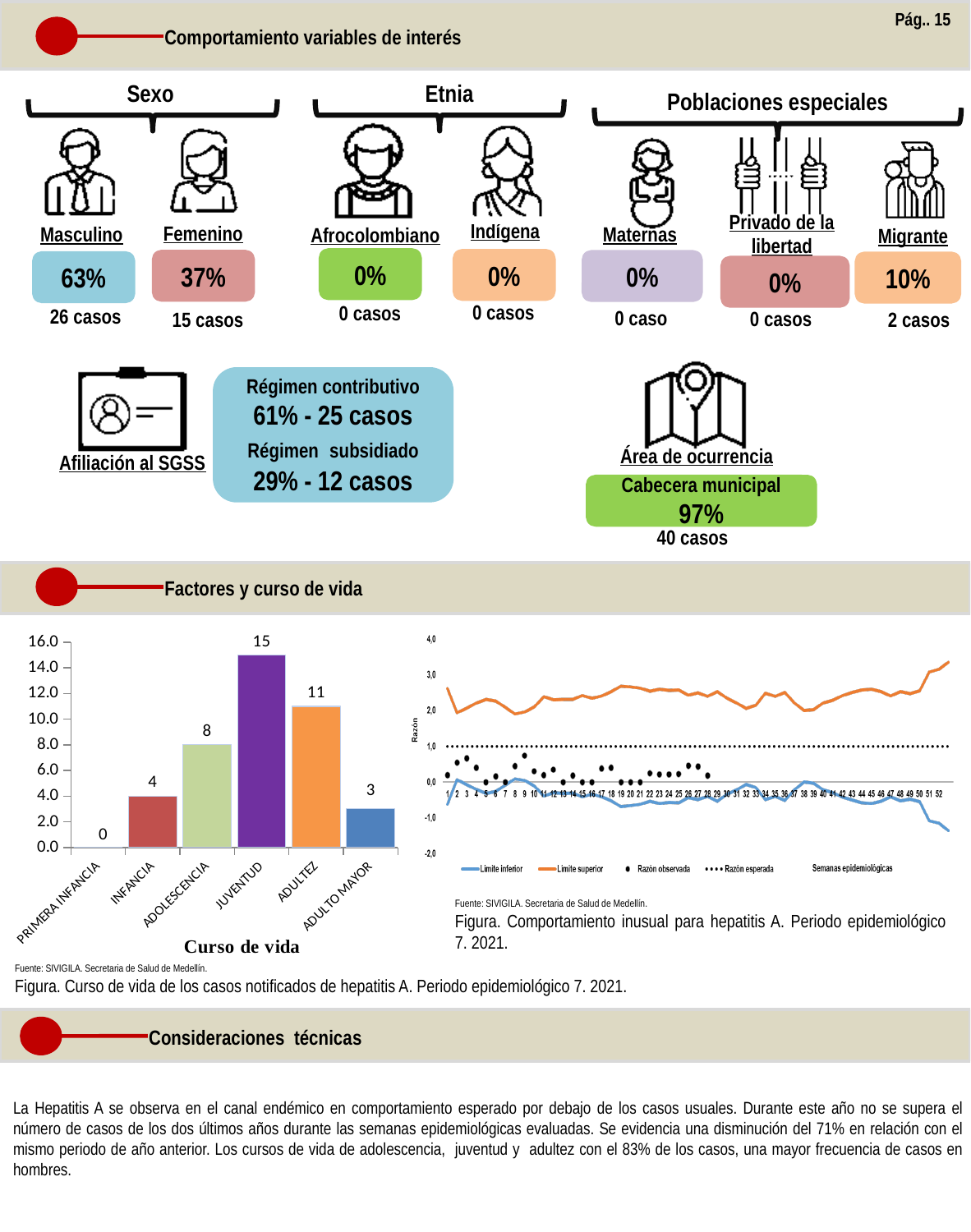
What kind of chart is the 'Curso de vida' chart on the left? Bar chart How many series does the legend list in the line chart on the right (Comportamiento inusual para hepatitis A)? 4 In the bar chart titled 'Curso de vida', what is the difference between the values for JUVENTUD and ADULTEZ? 4 In the line chart on the right (Comportamiento inusual para hepatitis A), what is the label of the y axis? Razón In the bar chart titled 'Curso de vida', what is the value for JUVENTUD? 15 How many categories are shown in the bar chart titled 'Curso de vida'? 6 In the bar chart titled 'Curso de vida', which category has the lowest value? PRIMERA INFANCIA In the bar chart titled 'Curso de vida', what is the value for INFANCIA? 4 In the bar chart titled 'Curso de vida', which is larger, the value for ADOLESCENCIA or the value for ADULTO MAYOR? ADOLESCENCIA In the bar chart titled 'Curso de vida', what is the value for ADULTEZ? 11 In the line chart on the right (Comportamiento inusual para hepatitis A), which series is drawn as a dotted line? Razón esperada In the bar chart titled 'Curso de vida', which category has the highest value? JUVENTUD